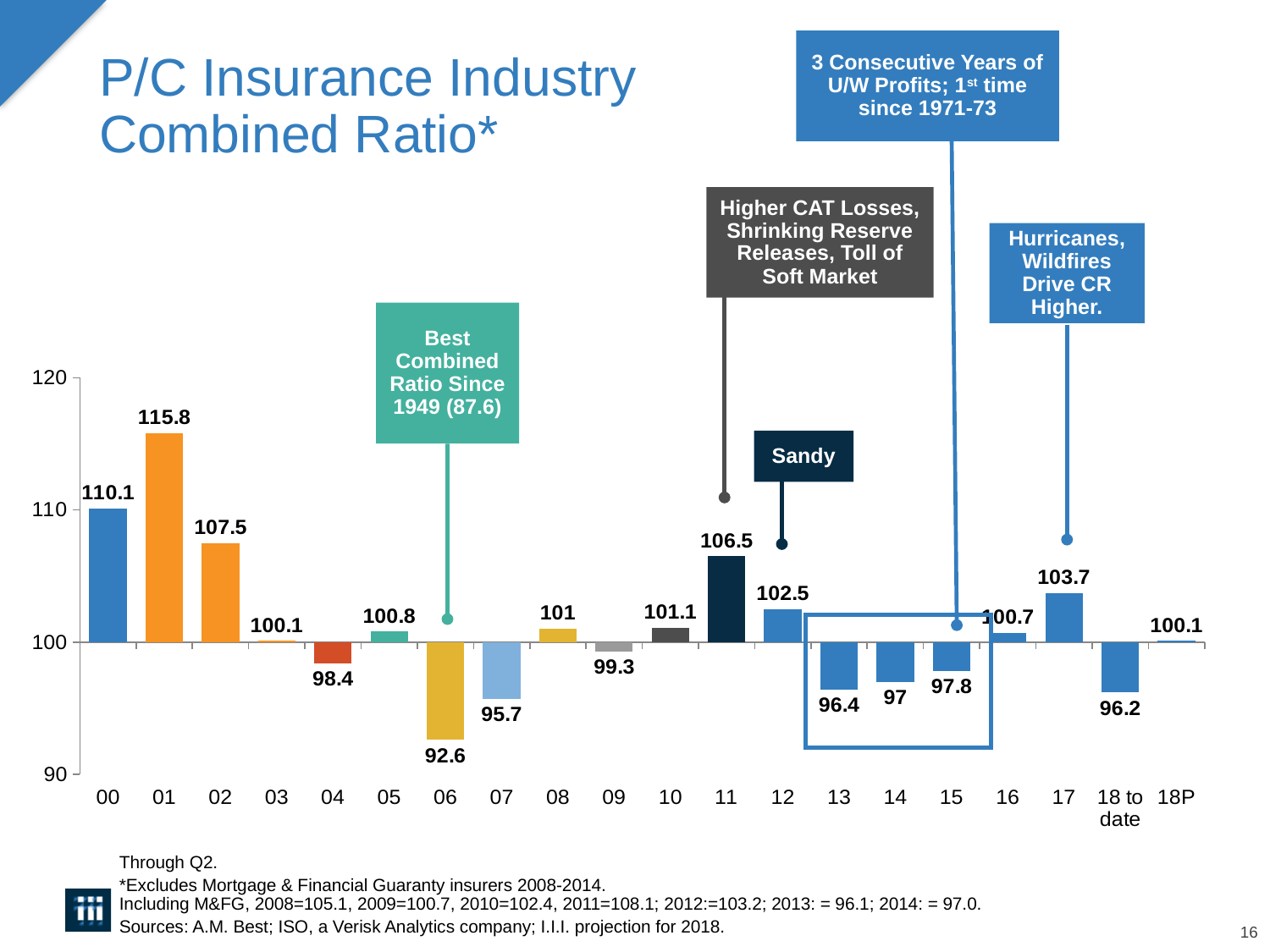
What kind of chart is shown on the slide? bar chart What value is shown for "18 to date"? 96.2 Which year has the highest combined ratio on the chart? 01 Is the combined ratio for 13 greater or less than 100? less How many categories are shown along the x axis? 20 Which year has the lowest combined ratio on the chart? 06 What is the difference between the combined ratio for 17 and for "18 to date"? 7.5 What is the combined ratio shown for 2017 ("17")? 103.7 What is the combined ratio shown for 2011 ("11")? 106.5 How much higher is the combined ratio for 01 than for 00? 5.7 From 13 through 17, does the combined ratio rise or fall? rise Which has the larger combined ratio, 12 or 16? 12